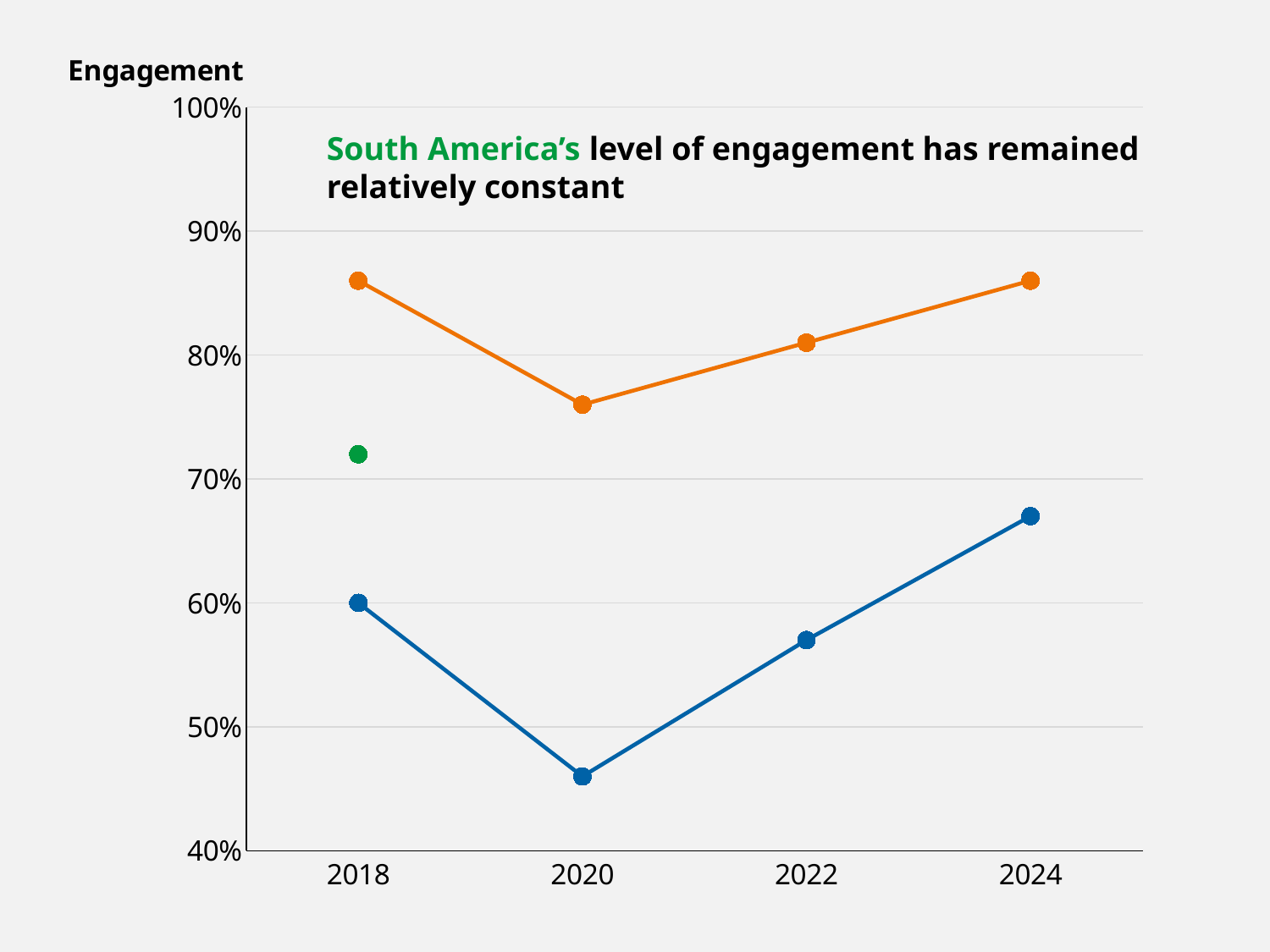
Is the value of the orange line in 2018 greater or less than 80%? greater Is the value of the green point in 2018 greater or less than 80%? less How many years are shown on the x axis? 4 Does the blue line rise or fall from 2020 to 2024? rise In which year is the blue line at its lowest? 2020 Is the value of the orange line in 2020 greater or less than 80%? less Which region is highlighted in green in the chart's headline? South America In which year is the blue line at its highest? 2024 What kind of chart is shown on the slide? line chart In which year is the orange line at its lowest? 2020